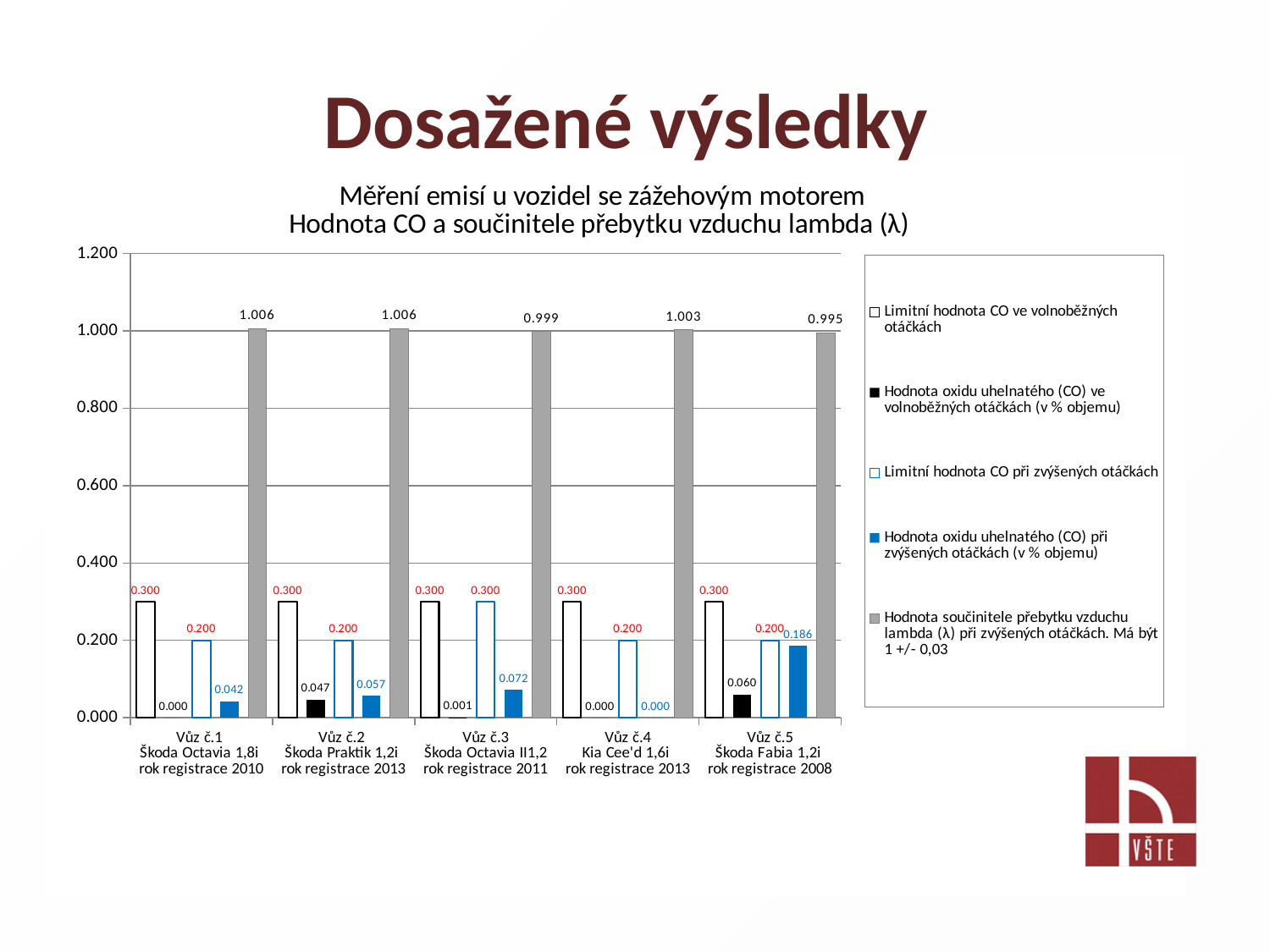
Which vehicle has the lowest lambda value (gray bars)? Vůz č.5 Škoda Fabia 1,2i Which is larger: the CO value at idle for Vůz č.5 or for Vůz č.2? Vůz č.5 Which series is shown in gray in the legend? Hodnota součinitele přebytku vzduchu lambda (λ) při zvýšených otáčkách. Má být 1 +/- 0,03 What is the CO value at idle (Hodnota oxidu uhelnatého (CO) ve volnoběžných otáčkách) for Vůz č.2 Škoda Praktik 1,2i? 0.047 What is the CO value at increased revs (Hodnota oxidu uhelnatého (CO) při zvýšených otáčkách) for Vůz č.3 Škoda Octavia II1,2? 0.072 How many series does the legend list? 5 How many vehicles (categories) are shown on the x axis? 5 What is the difference between the lambda value of Vůz č.1 and Vůz č.3? 0.007 Which vehicle has the highest CO value at increased revs (blue bars)? Vůz č.5 Škoda Fabia 1,2i What is the lambda value (Hodnota součinitele přebytku vzduchu lambda) for Vůz č.5 Škoda Fabia 1,2i? 0.995 What type of chart is shown on the slide? bar chart What is the limit value of CO at increased revs (Limitní hodnota CO při zvýšených otáčkách) for Vůz č.3 Škoda Octavia II1,2? 0.300